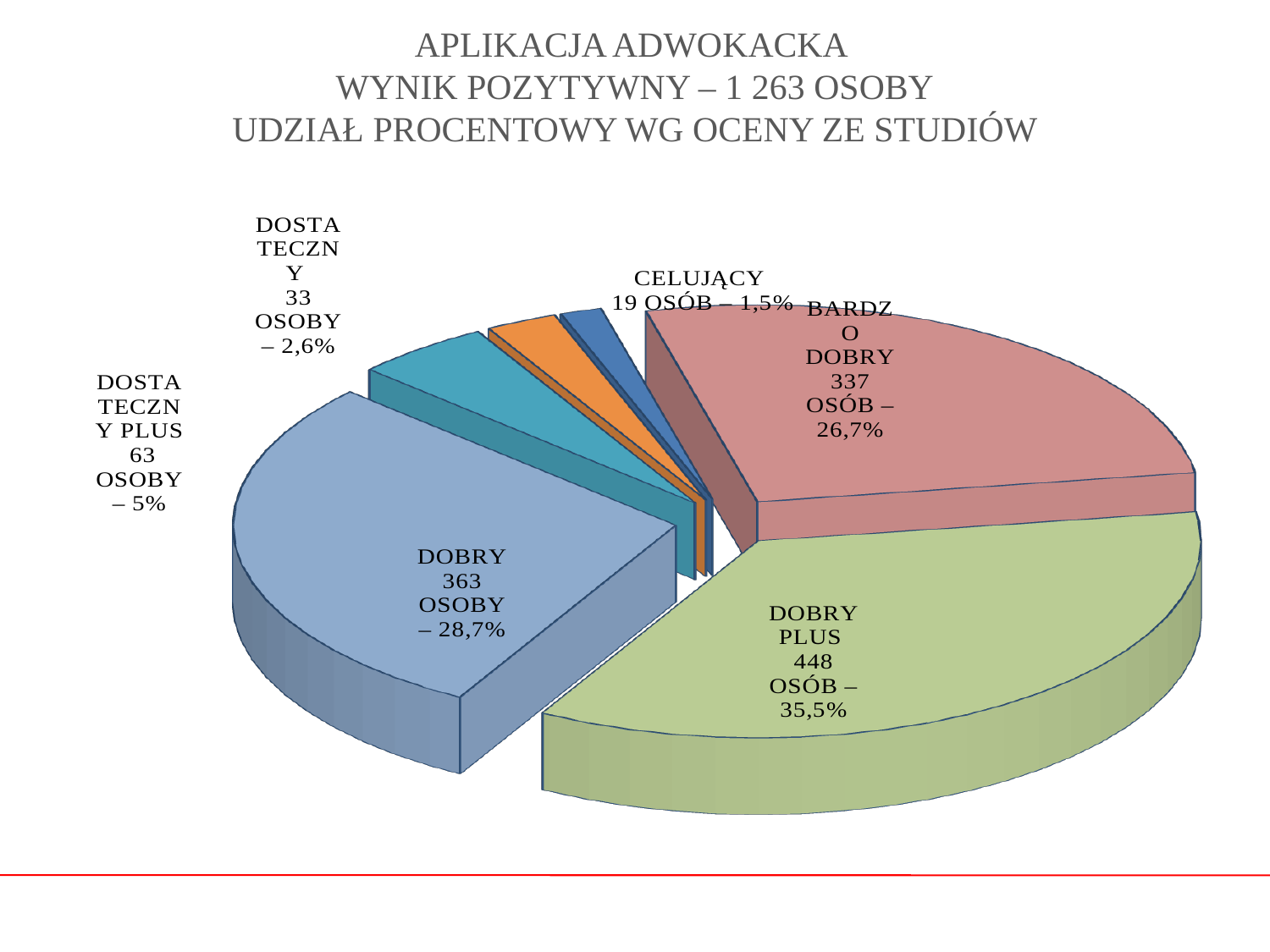
What is the difference in number of people between DOBRY PLUS and DOBRY? 85 Which category has the largest slice of the pie? DOBRY PLUS Which category has the smallest slice of the pie? CELUJĄCY Which category has more people, DOSTATECZNY PLUS or DOSTATECZNY? DOSTATECZNY PLUS What percentage share does the DOBRY PLUS slice have? 35,5% What kind of chart is shown on the slide? pie chart What is the total number of people with a positive result given in the chart title? 1 263 How many slices does the pie chart have? 6 How many people are in the BARDZO DOBRY category? 337 What percentage share does the DOSTATECZNY PLUS slice have? 5% How many people are in the DOBRY category? 363 What percentage share does the CELUJĄCY slice have? 1,5%